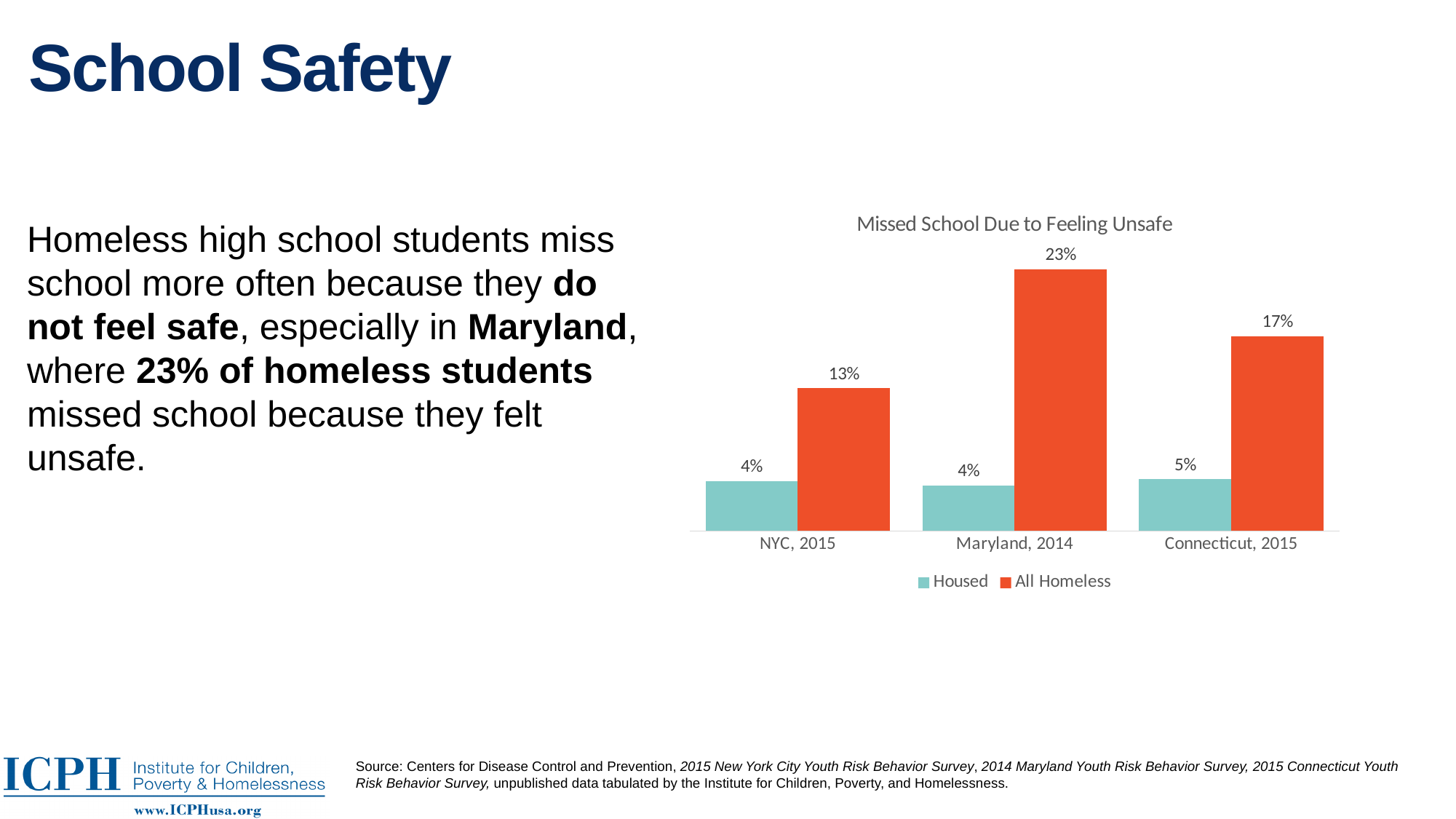
What is the difference between the All Homeless values for Connecticut, 2015 and NYC, 2015? 4% How many categories are shown on the x axis? 3 What is the value for All Homeless in NYC, 2015? 13% Which category has the highest All Homeless value? Maryland, 2014 What is the difference between the All Homeless and Housed values in Maryland, 2014? 19% How many series does the legend list? 2 What is the title of the chart? Missed School Due to Feeling Unsafe Which is larger: the All Homeless value for Connecticut, 2015 or for NYC, 2015? Connecticut, 2015 What is the value for Housed in Connecticut, 2015? 5% What kind of chart is shown? Bar chart What is the value for All Homeless in Maryland, 2014? 23% Which category has the lowest All Homeless value? NYC, 2015